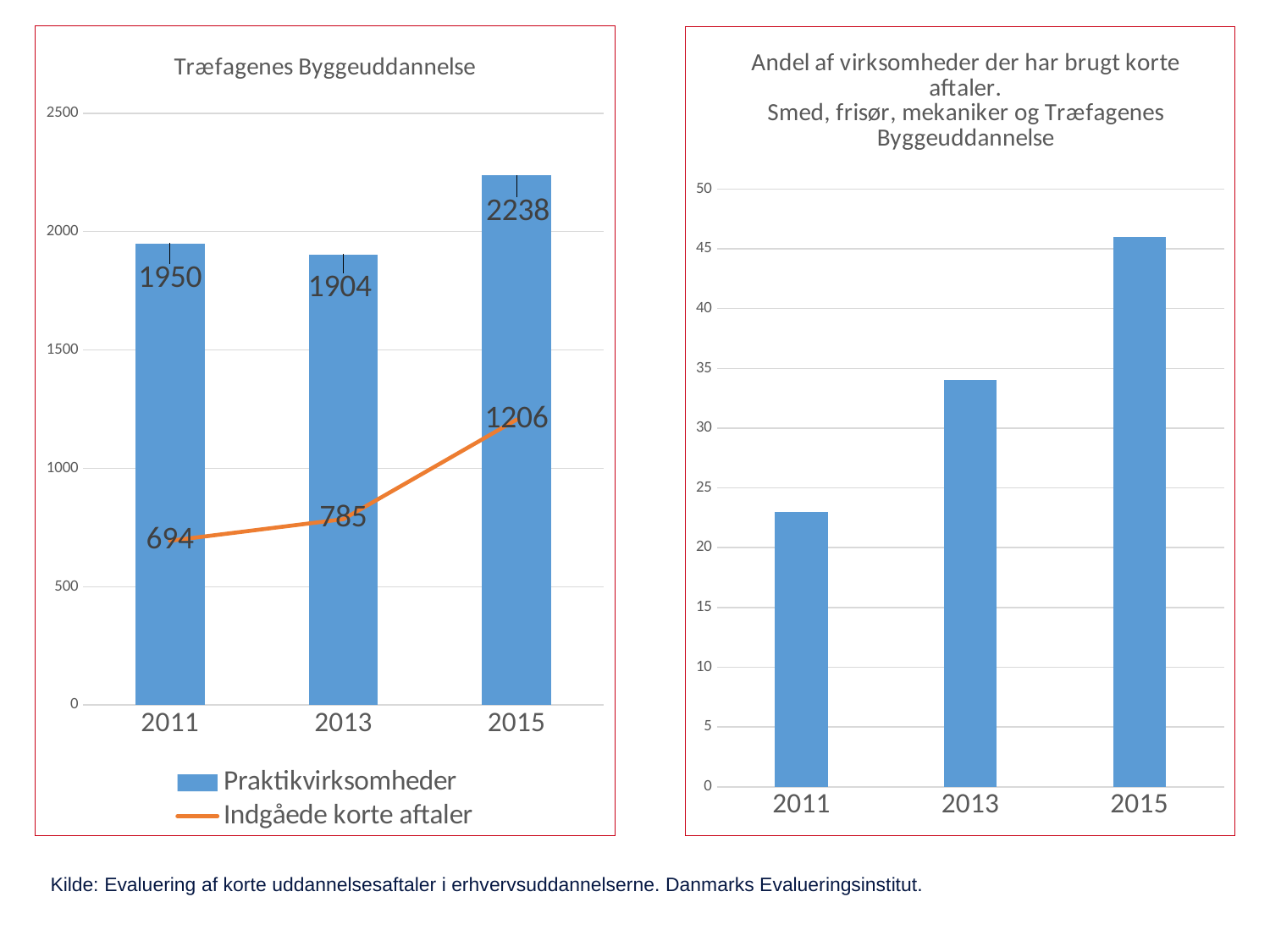
In the chart titled "Træfagenes Byggeuddannelse", what is the value of Praktikvirksomheder for 2015? 2238 In the chart on the right ("Andel af virksomheder der har brugt korte aftaler"), is the value for 2015 greater or less than 45? greater In the chart titled "Træfagenes Byggeuddannelse", how many series does the legend list? 2 In the chart titled "Træfagenes Byggeuddannelse", what is the difference between Praktikvirksomheder in 2015 and in 2011? 288 In the chart titled "Træfagenes Byggeuddannelse", does Indgåede korte aftaler rise or fall from 2011 to 2015? rise In the chart titled "Træfagenes Byggeuddannelse", what is the value of Indgåede korte aftaler for 2011? 694 In the chart titled "Træfagenes Byggeuddannelse", which year has the lowest value for Praktikvirksomheder? 2013 What kind of chart is the chart on the right ("Andel af virksomheder der har brugt korte aftaler")? bar chart In the chart titled "Træfagenes Byggeuddannelse", which series is drawn as an orange line? Indgåede korte aftaler In the chart titled "Træfagenes Byggeuddannelse", what is the value of Indgåede korte aftaler for 2013? 785 In the chart on the right ("Andel af virksomheder der har brugt korte aftaler"), which year has the highest value? 2015 In the chart on the right ("Andel af virksomheder der har brugt korte aftaler"), is the value for 2011 greater or less than 25? less